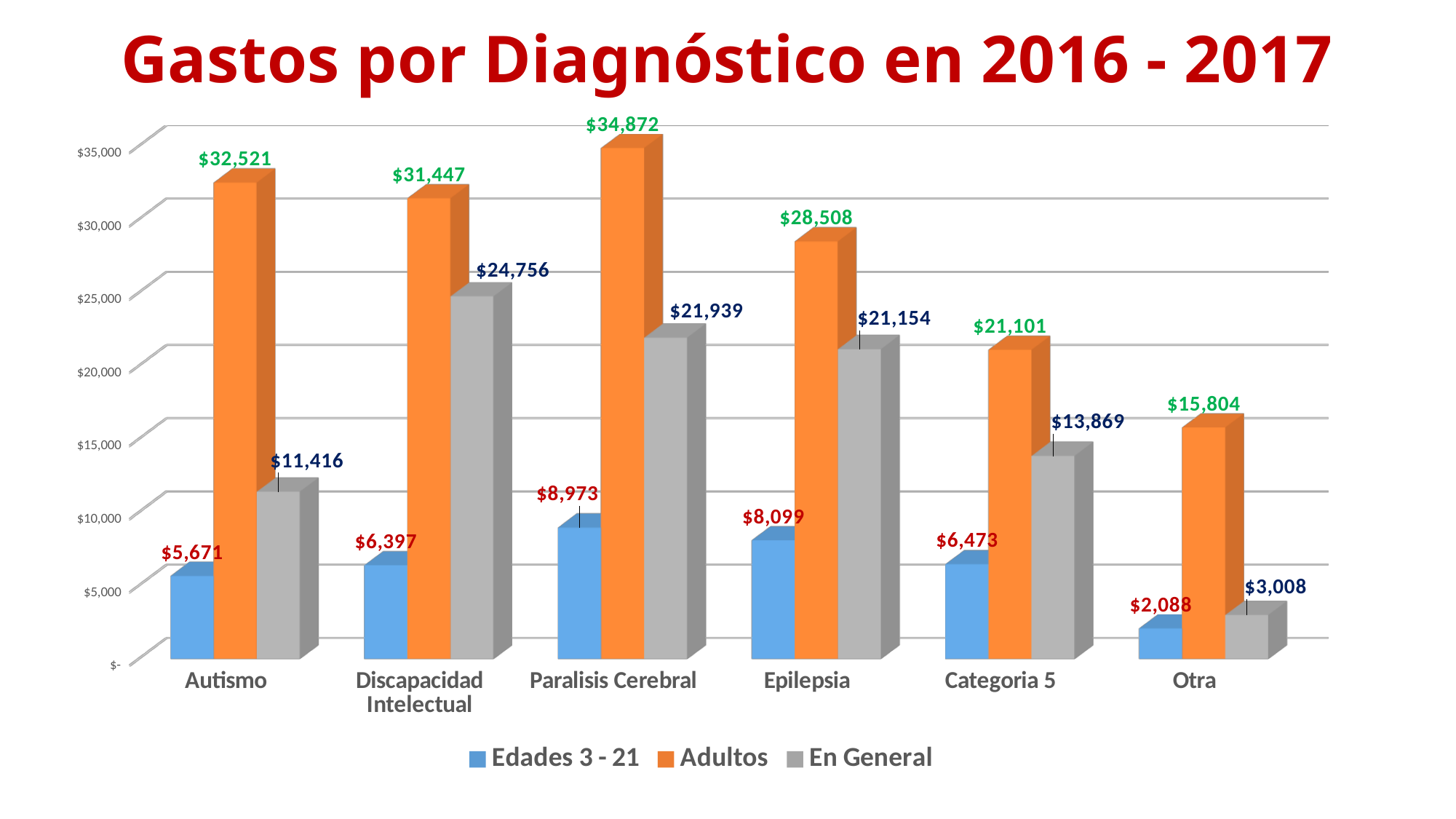
Is the Adultos value for Otra greater or less than $20,000? less What is the title of the chart? Gastos por Diagnóstico en 2016 - 2017 Which category has the highest Adultos value? Paralisis Cerebral Which category has the lowest En General value? Otra What kind of chart is shown on the slide? bar chart Which is larger for Categoria 5: the Adultos value or the En General value? Adultos What is the difference between the Adultos and Edades 3 - 21 values for Autismo? $26,850 What is the En General value for Discapacidad Intelectual? $24,756 What is the Edades 3 - 21 value for Epilepsia? $8,099 How many diagnosis categories are shown on the x axis? 6 What is the Adultos value for Paralisis Cerebral? $34,872 How many series does the legend list? 3